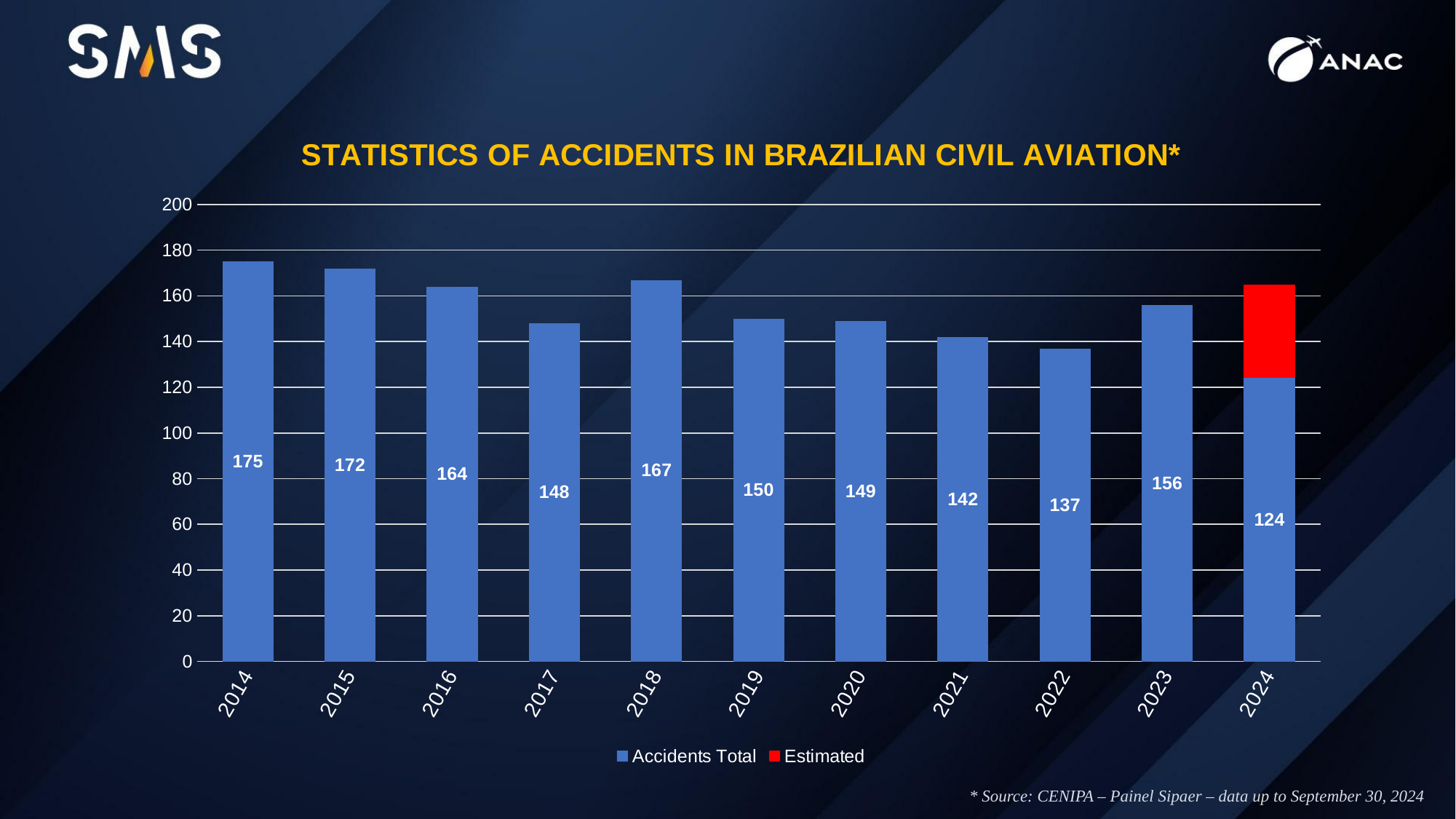
What is the Accidents Total value for 2014? 175 What is the Accidents Total value shown for 2024? 124 What is the Accidents Total value for 2022? 137 Do the Accidents Total values rise or fall from 2014 to 2017? fall Which year has the lowest labelled Accidents Total value? 2024 What is the difference between the Accidents Total values for 2014 and 2023? 19 Is the top of the 2024 bar, including the Estimated portion, greater or less than 140? greater Which year has the highest Accidents Total value? 2014 What kind of chart is shown on the slide? bar chart How many series does the legend list? 2 How many years are shown on the x axis? 11 Which year has a larger Accidents Total value, 2016 or 2018? 2018